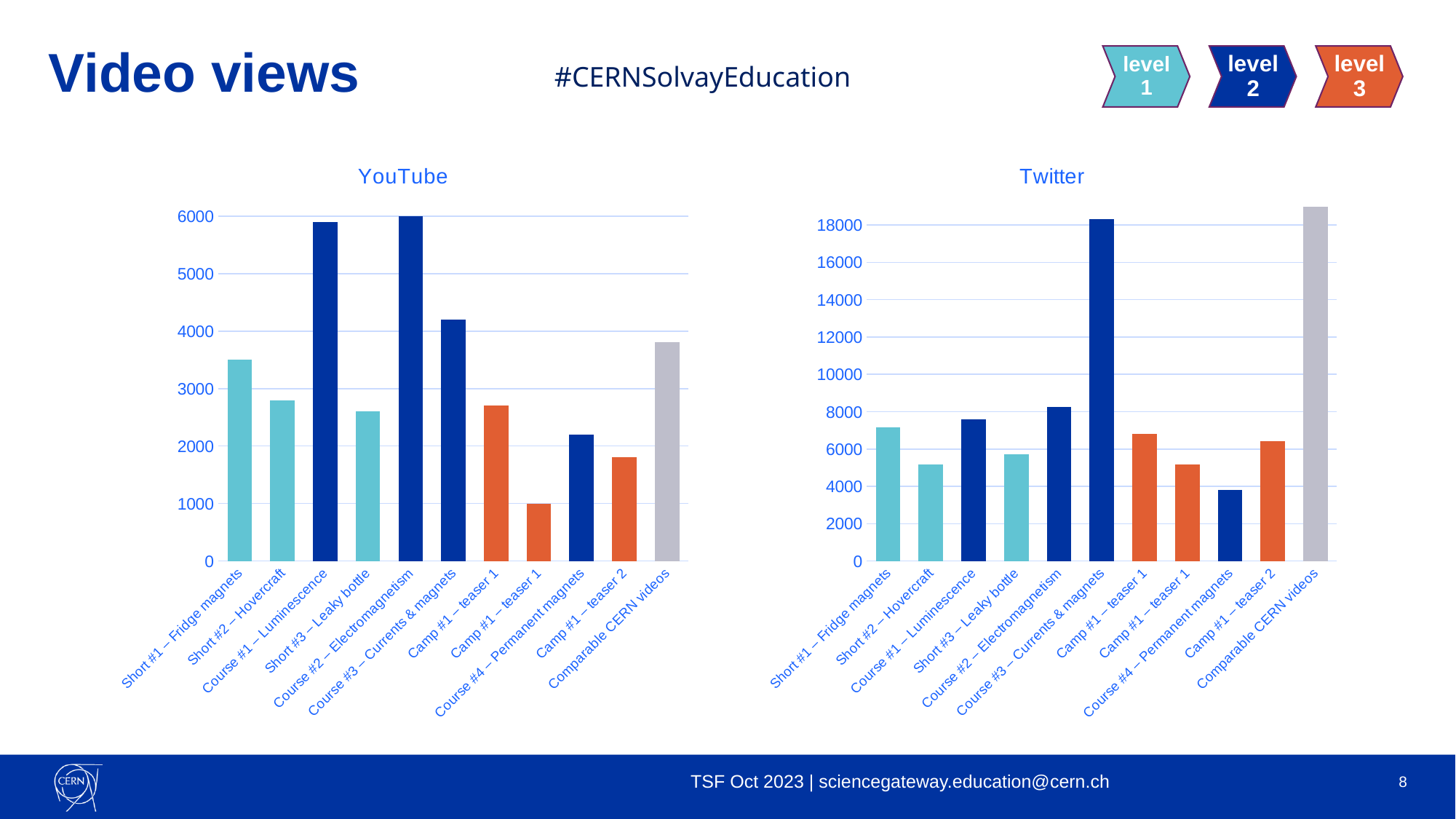
On the YouTube chart, which is larger: Short #1 – Fridge magnets or Short #2 – Hovercraft? Short #1 – Fridge magnets What kind of chart is the YouTube chart? bar chart On the Twitter chart, what colour is the bar for Comparable CERN videos? grey On the YouTube chart, which category has the lowest value? Camp #1 – teaser 1 On the YouTube chart, is the value for Comparable CERN videos greater or less than 3000? greater On the YouTube chart, is the value for Course #3 – Currents & magnets greater or less than 4000? greater How many categories are shown on the Twitter chart? 11 On the Twitter chart, is the value for Course #3 – Currents & magnets greater or less than 16000? greater On the Twitter chart, which is larger: Course #2 – Electromagnetism or Course #1 – Luminescence? Course #2 – Electromagnetism On the Twitter chart, which category has the lowest value? Course #4 – Permanent magnets What are the titles of the two charts on the slide? YouTube and Twitter